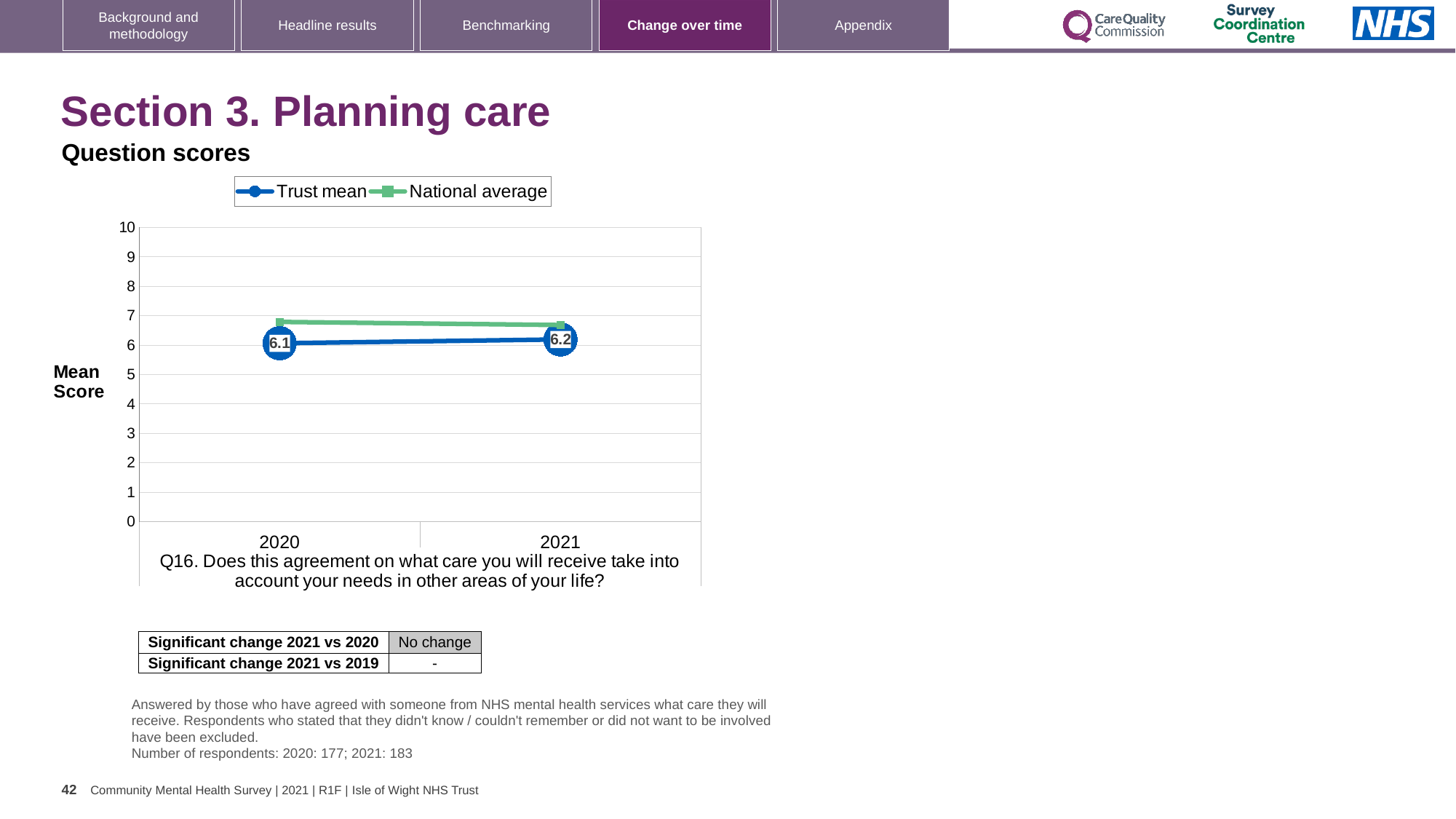
How many series does the chart legend list? 2 What is the Trust mean score for 2020? 6.1 Is the National average value for 2020 greater or less than 6? greater What is the label on the y axis of the chart? Mean Score Is the National average value for 2021 greater or less than 7? less By how much did the Trust mean score change from 2020 to 2021? 0.1 What type of chart is shown on the slide? Line chart What is the Trust mean score for 2021? 6.2 How many years are plotted on the x axis of the chart? 2 Does the Trust mean rise or fall from 2020 to 2021? Rise In 2020, which series is higher: Trust mean or National average? National average Which year has the higher Trust mean score, 2020 or 2021? 2021